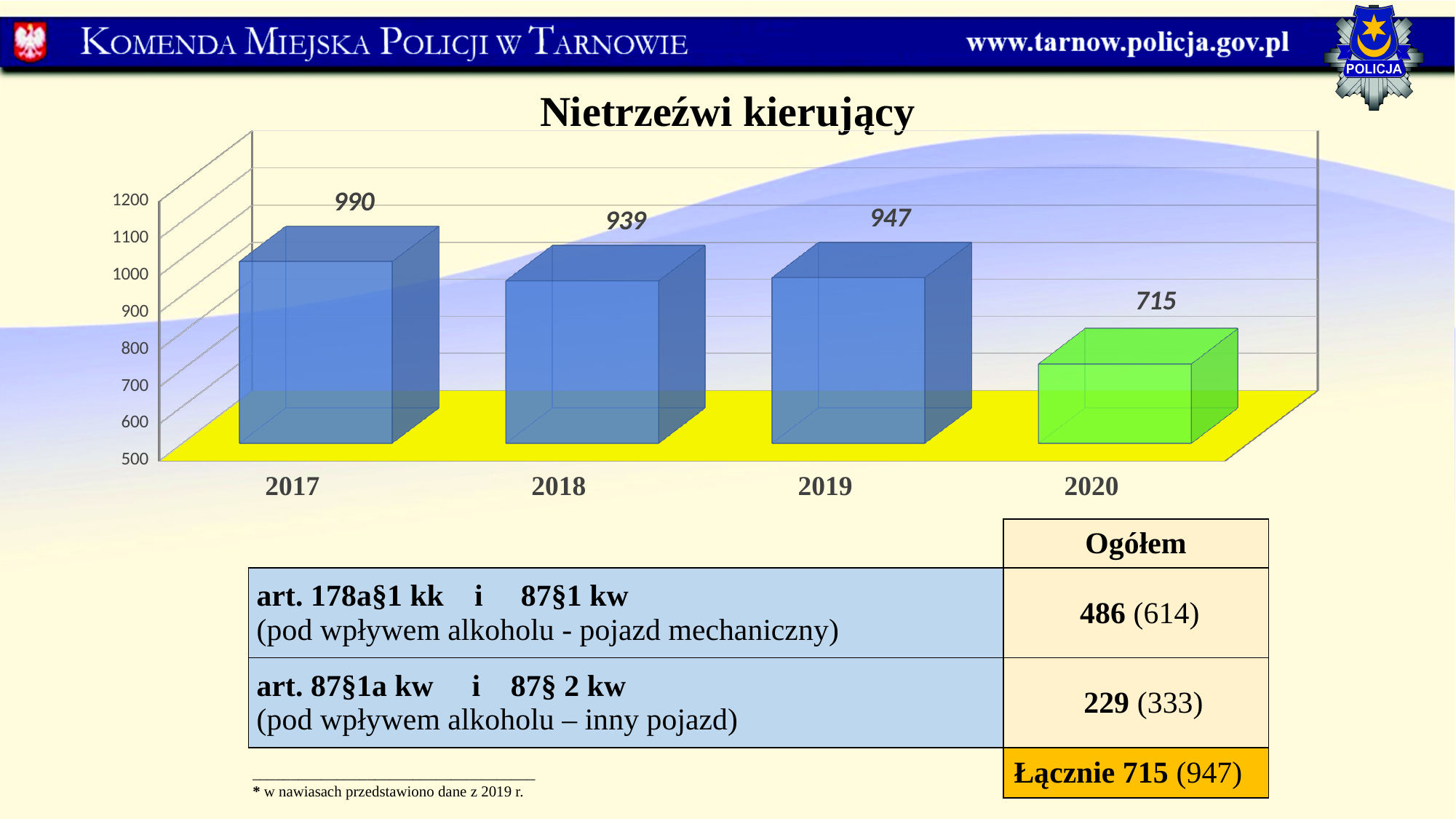
What kind of chart is shown on the slide? bar chart What is the title of the chart? Nietrzeźwi kierujący Which year has the highest value in the chart? 2017 What is the value for 2017 in the chart? 990 What is the difference between the values for 2017 and 2018? 51 What is the value for 2018 in the chart? 939 Which is larger, the value for 2018 or the value for 2019? 2019 What is the value for 2020 in the chart? 715 What is the value for 2019 in the chart? 947 What is the difference between the values for 2019 and 2020? 232 How many years are shown in the chart? 4 Which year has the lowest value in the chart? 2020